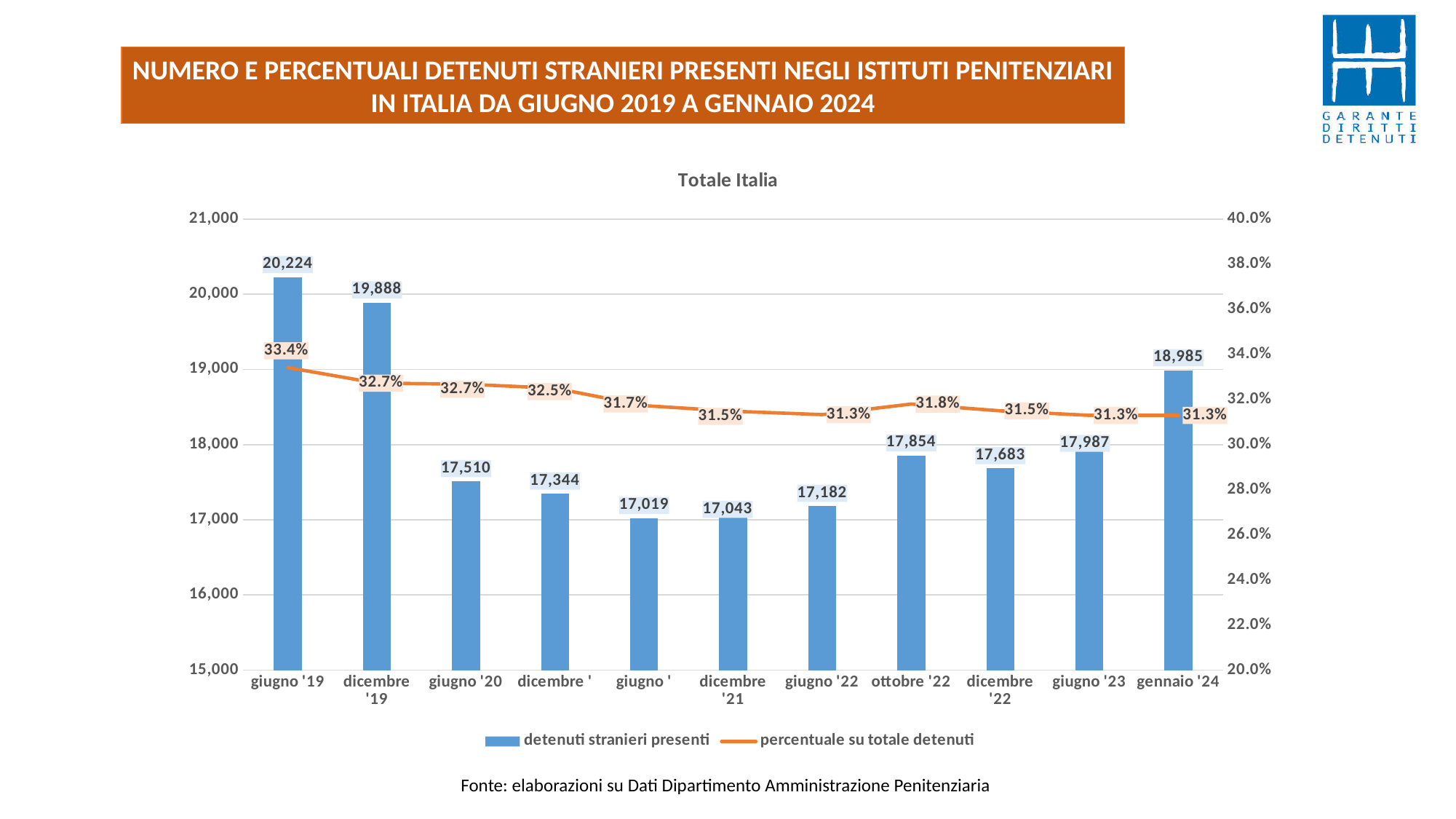
What is the value of 'detenuti stranieri presenti' for giugno '19? 20,224 What is the 'percentuale su totale detenuti' for giugno '19? 33.4% What is the difference in 'detenuti stranieri presenti' between giugno '19 and dicembre '19? 336 Which category has the lowest value of 'detenuti stranieri presenti'? giugno ' What colour is the 'percentuale su totale detenuti' line? Orange What is the chart's title? Totale Italia Which is larger, the 'detenuti stranieri presenti' value for giugno '23 or for dicembre '22? giugno '23 What is the value of 'detenuti stranieri presenti' for gennaio '24? 18,985 Which category has the highest value of 'detenuti stranieri presenti'? giugno '19 How many categories are shown on the x axis? 11 How many series does the legend list? 2 What is the 'percentuale su totale detenuti' for ottobre '22? 31.8%